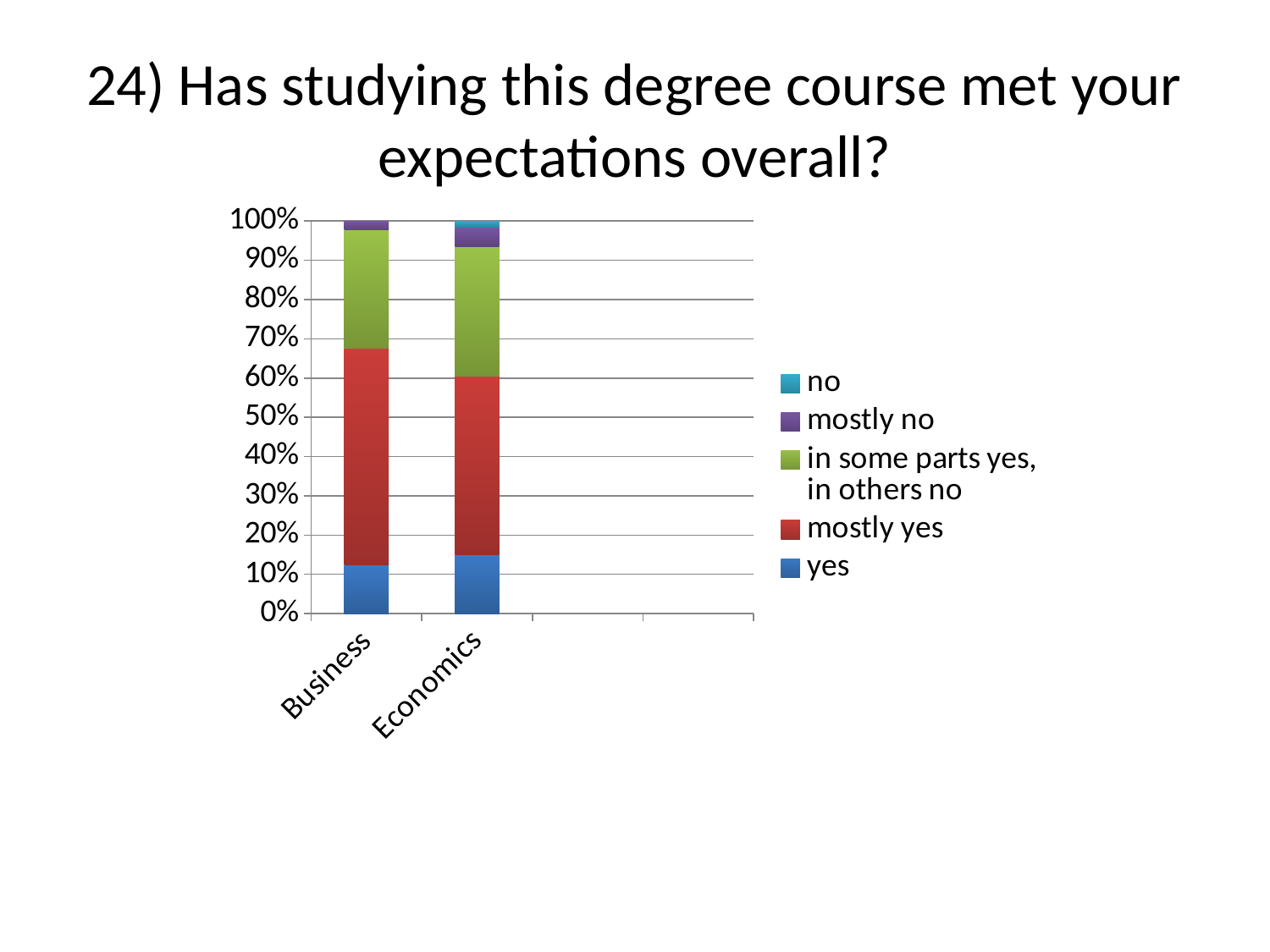
Which category has the larger 'no' segment, Business or Economics? Economics Is the combined share of 'yes' and 'mostly yes' for Economics greater or less than 80%? less How many categories are shown on the x axis of the chart? 2 What kind of chart is shown on the slide? stacked bar chart What is the title of the chart on the slide? 24) Has studying this degree course met your expectations overall? Is the combined share of 'yes' and 'mostly yes' for Business greater or less than 60%? greater How many series does the chart's legend list? 5 What is the total height of the Business bar? 100% Is the 'yes' share for Economics greater or less than 20%? less Which category has the larger 'mostly yes' segment, Business or Economics? Business Which legend entry is shown in red? mostly yes